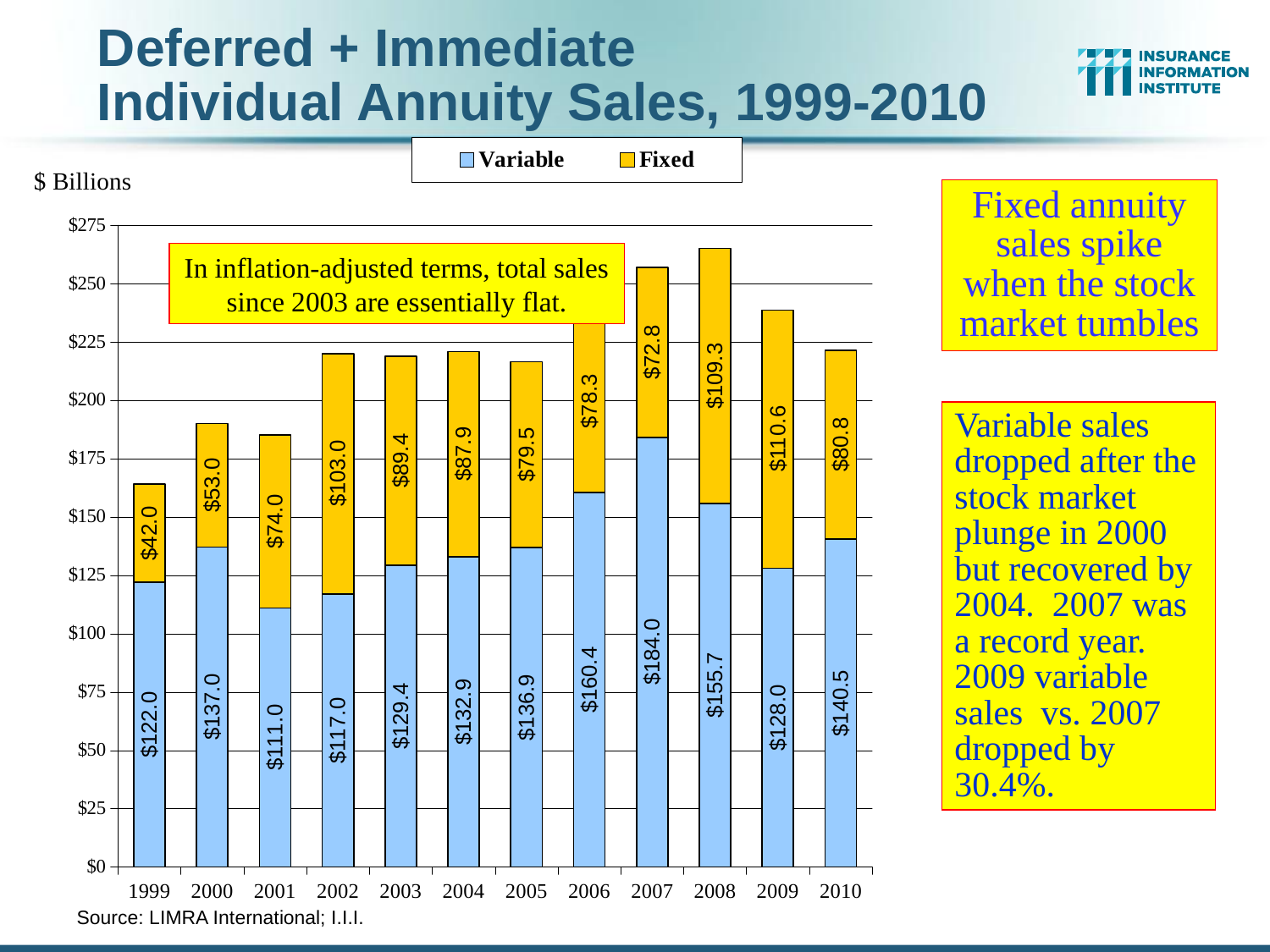
What was the total of Variable and Fixed annuity sales in 2008? $265.0 Which year had the lowest Variable annuity sales? 2001 How many series does the legend list? 2 Which was larger, Fixed annuity sales in 2002 or in 2010? 2002 Which year had the highest Variable annuity sales? 2007 What were Fixed annuity sales in 1999? $42.0 What were Fixed annuity sales in 2009? $110.6 Which year had the lowest Fixed annuity sales? 1999 How many years are shown on the x axis? 12 What is the difference between Variable annuity sales in 2007 and in 2009? $56.0 What kind of chart is shown on the slide? Stacked bar chart What were Variable annuity sales in 2007? $184.0